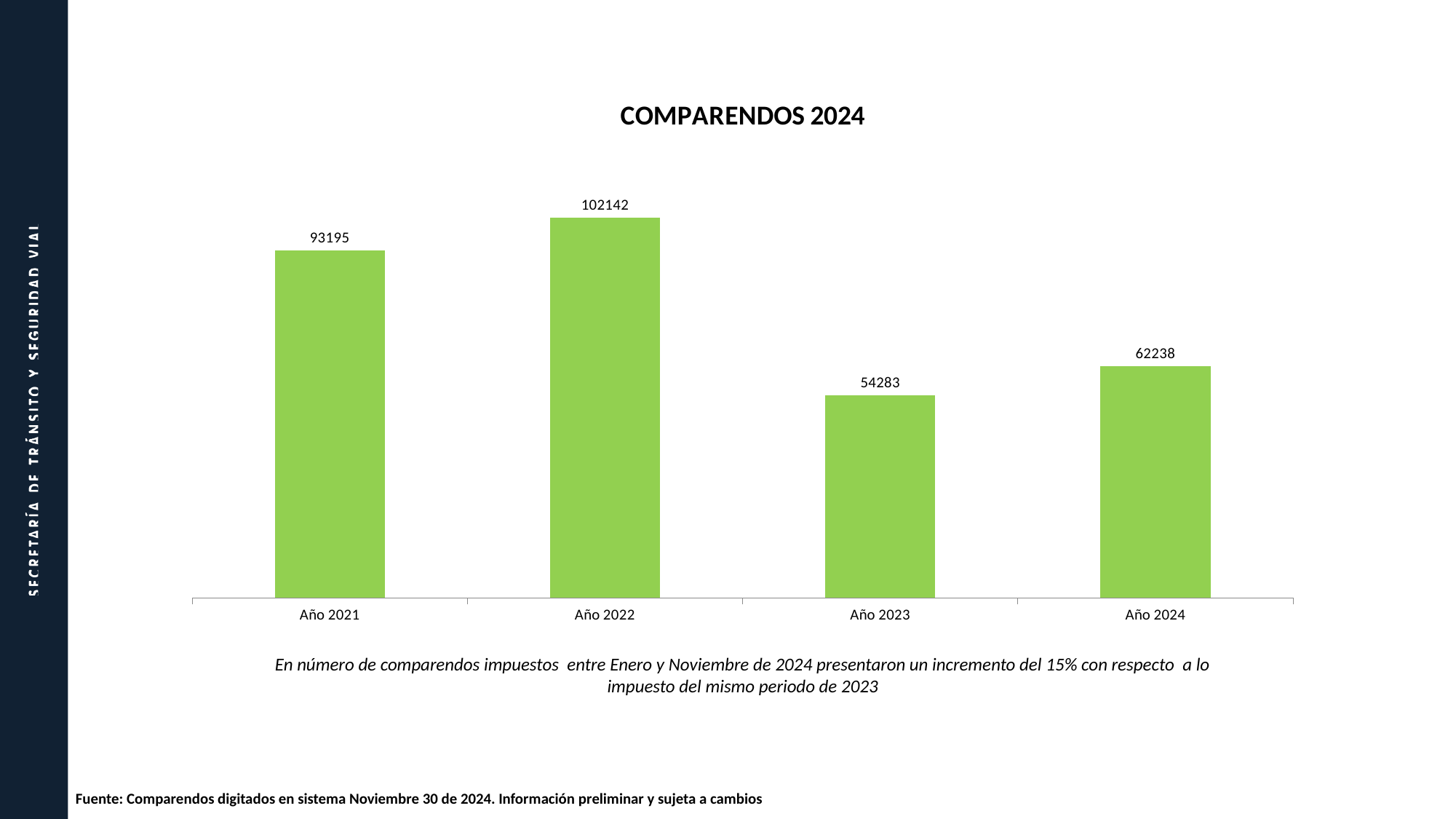
What is the difference between the values for Año 2022 and Año 2021? 8947 What is the value for Año 2024 in the COMPARENDOS 2024 chart? 62238 What is the value for Año 2023 in the COMPARENDOS 2024 chart? 54283 Which year has the lowest value in the COMPARENDOS 2024 chart? Año 2023 What is the value for Año 2021 in the COMPARENDOS 2024 chart? 93195 What is the value for Año 2022 in the COMPARENDOS 2024 chart? 102142 Does the value rise or fall from Año 2022 to Año 2023? Fall Which is larger, the value for Año 2021 or the value for Año 2024? Año 2021 How many years are shown on the x axis of the COMPARENDOS 2024 chart? 4 Which year has the highest value in the COMPARENDOS 2024 chart? Año 2022 What is the difference between the values for Año 2024 and Año 2023? 7955 What kind of chart is shown on the slide? Bar chart